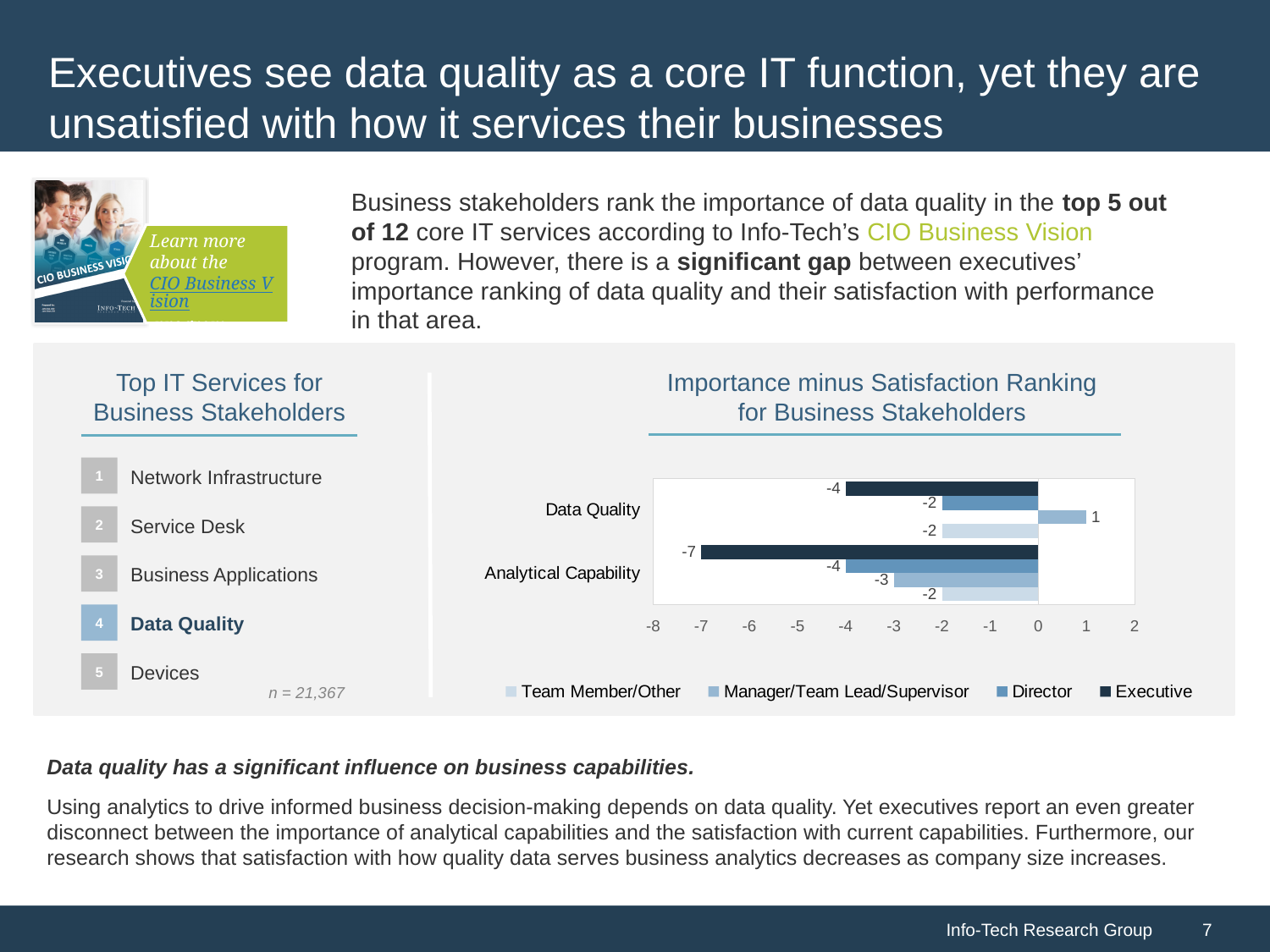
In the 'Importance minus Satisfaction Ranking for Business Stakeholders' chart, is the Executive value for Data Quality larger or smaller than the Executive value for Analytical Capability? larger What kind of chart is the 'Importance minus Satisfaction Ranking for Business Stakeholders' chart? Bar chart In the 'Importance minus Satisfaction Ranking for Business Stakeholders' chart, which series has the highest value for Data Quality? Manager/Team Lead/Supervisor In the 'Importance minus Satisfaction Ranking for Business Stakeholders' chart, what is the value for Executive for Analytical Capability? -7 In the 'Importance minus Satisfaction Ranking for Business Stakeholders' chart, what is the value for Director for Analytical Capability? -4 How many series does the legend of the 'Importance minus Satisfaction Ranking for Business Stakeholders' chart list? 4 In the 'Importance minus Satisfaction Ranking for Business Stakeholders' chart, what is the value for Manager/Team Lead/Supervisor for Data Quality? 1 In the 'Importance minus Satisfaction Ranking for Business Stakeholders' chart, which series has the lowest value for Analytical Capability? Executive How many categories are shown on the 'Importance minus Satisfaction Ranking for Business Stakeholders' chart? 2 In the 'Importance minus Satisfaction Ranking for Business Stakeholders' chart, what is the value for Team Member/Other for Analytical Capability? -2 In the 'Importance minus Satisfaction Ranking for Business Stakeholders' chart, what is the difference between the Executive values for Analytical Capability and Data Quality? 3 In the 'Importance minus Satisfaction Ranking for Business Stakeholders' chart, what is the value for Executive for Data Quality? -4